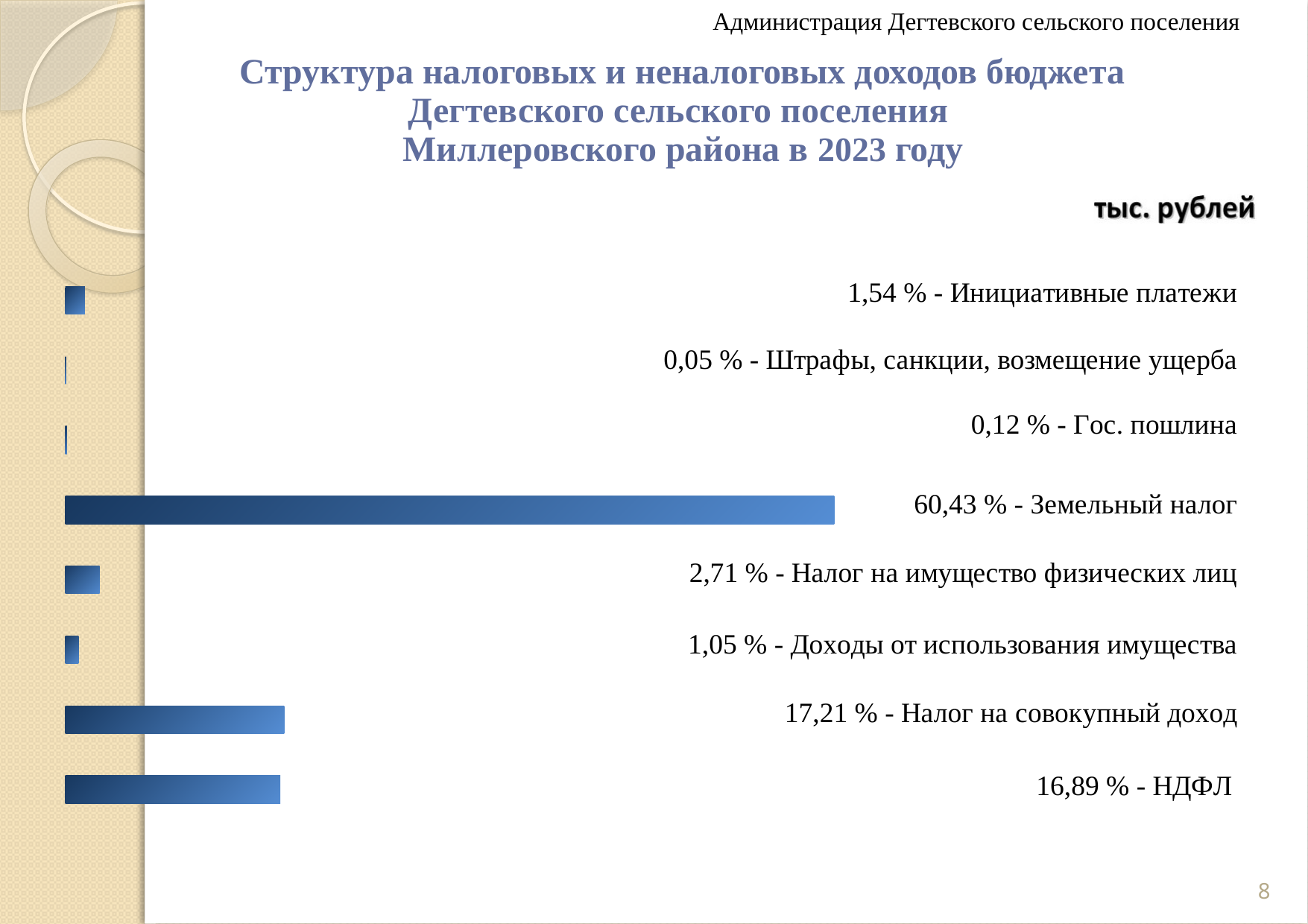
What is the value shown for НДФЛ? 16,89 % What is the value for Налог на имущество физических лиц? 2,71 % What is the difference between Земельный налог and Налог на совокупный доход? 43,22 % What is the difference between Налог на совокупный доход and НДФЛ? 0,32 % Which category has the lowest value in the chart? Штрафы, санкции, возмещение ущерба What kind of chart is shown on the slide? Bar chart How many categories are shown in the chart? 8 What share does Земельный налог have in the chart? 60,43 % Which category has the highest value in the chart? Земельный налог Which is larger, Инициативные платежи or Доходы от использования имущества? Инициативные платежи What is the value for Штрафы, санкции, возмещение ущерба? 0,05 % What percentage is shown for Налог на совокупный доход? 17,21 %